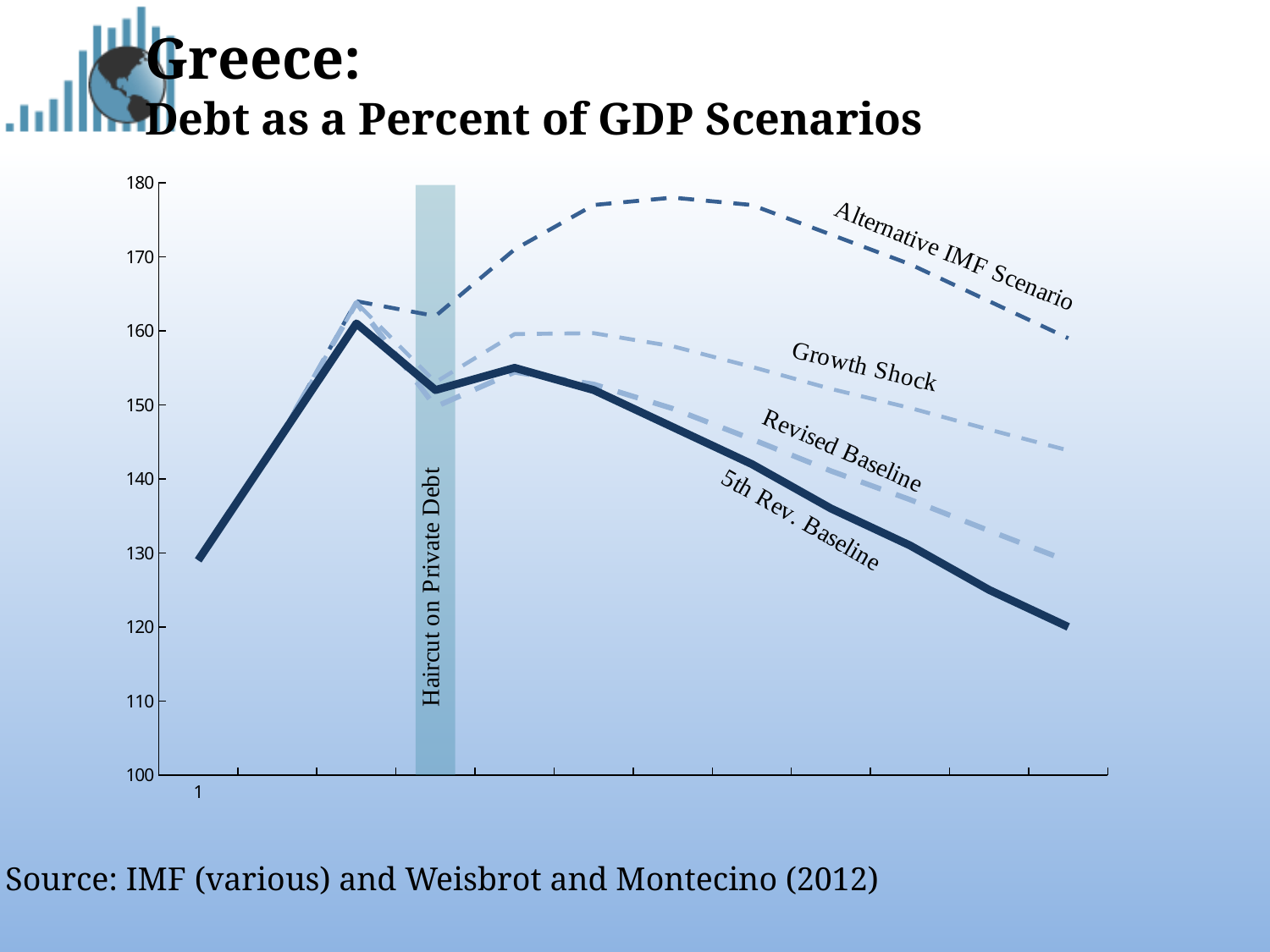
Is the final value of the Growth Shock line greater or less than 140? greater At the right end of the chart, which is higher: Revised Baseline or 5th Rev. Baseline? Revised Baseline Is the final value of the Alternative IMF Scenario line greater or less than 150? greater What event does the shaded vertical band on the chart mark? Haircut on Private Debt Over the right half of the chart, does the 5th Rev. Baseline line rise or fall? fall Is the peak value of the Alternative IMF Scenario line greater or less than 170? greater Which scenario reaches the highest debt-to-GDP value on the chart? Alternative IMF Scenario How many scenarios are plotted on the chart? 4 What kind of chart is shown on the slide? line chart Which scenario ends at the lowest value at the right end of the chart? 5th Rev. Baseline At the right end of the chart, which is higher: Growth Shock or Revised Baseline? Growth Shock